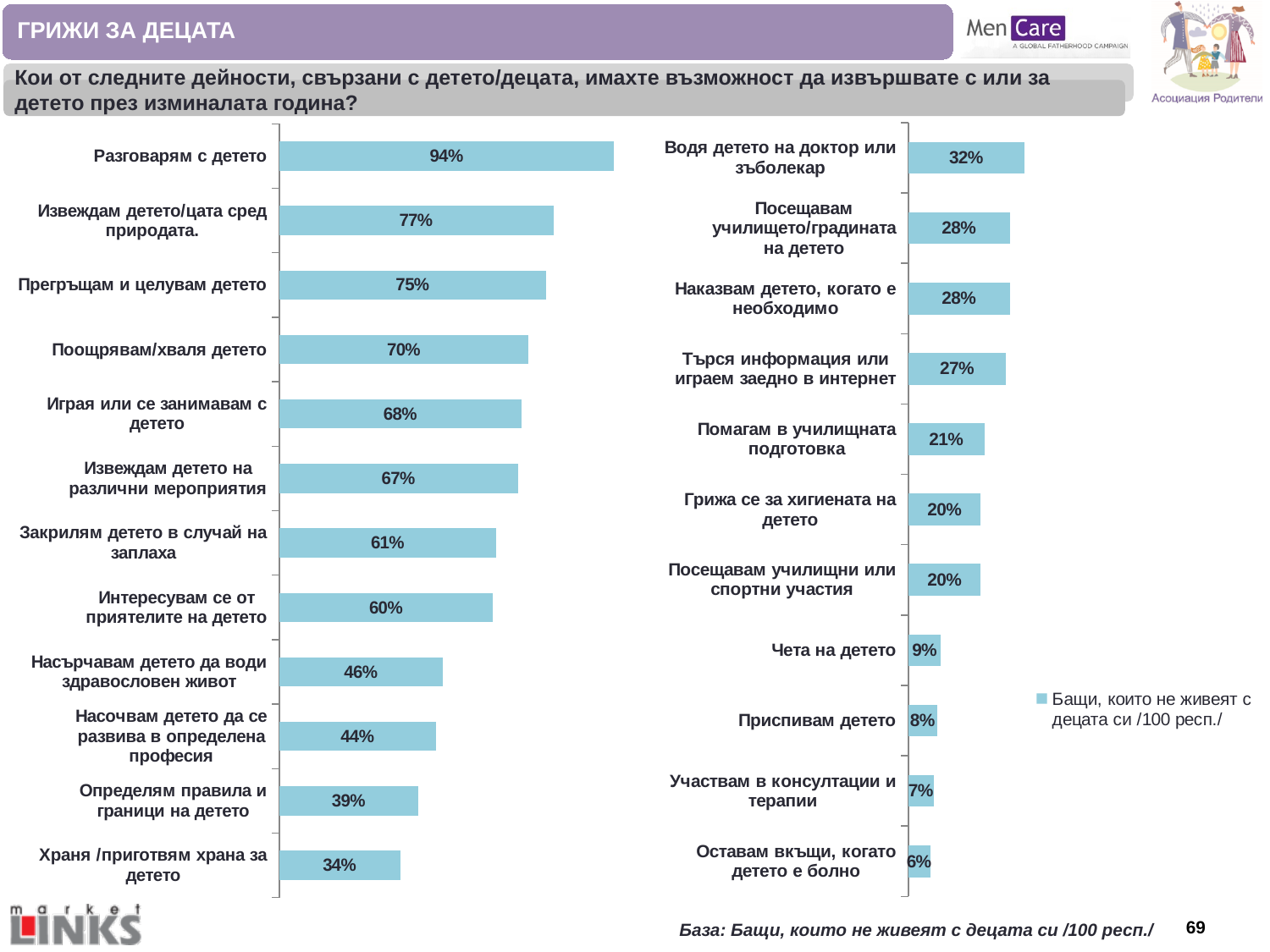
In the right chart, what is the value for "Помагам в училищната подготовка"? 21% In the left chart, which is larger: the value for "Поощрявам/хваля детето" or the value for "Закрилям детето в случай на заплаха"? Поощрявам/хваля детето In the left chart, what is the difference between the values for "Разговарям с детето" and "Извеждам детето/цата сред природата."? 17% In the left chart, what is the value for "Храня /приготвям храна за детето"? 34% How many categories are shown in the right chart? 11 In the left chart, what is the value for "Разговарям с детето"? 94% In the right chart, which category has the lowest value? Оставам вкъщи, когато детето е болно In the right chart, which is larger: the value for "Чета на детето" or the value for "Търся информация или играем заедно в интернет"? Търся информация или играем заедно в интернет How many categories are shown in the left chart? 12 In the right chart, which category has the highest value? Водя детето на доктор или зъболекар What type of chart is used on the left side of the slide? Bar chart What series name does the legend on the slide show? Бащи, които не живеят с децата си /100 респ./